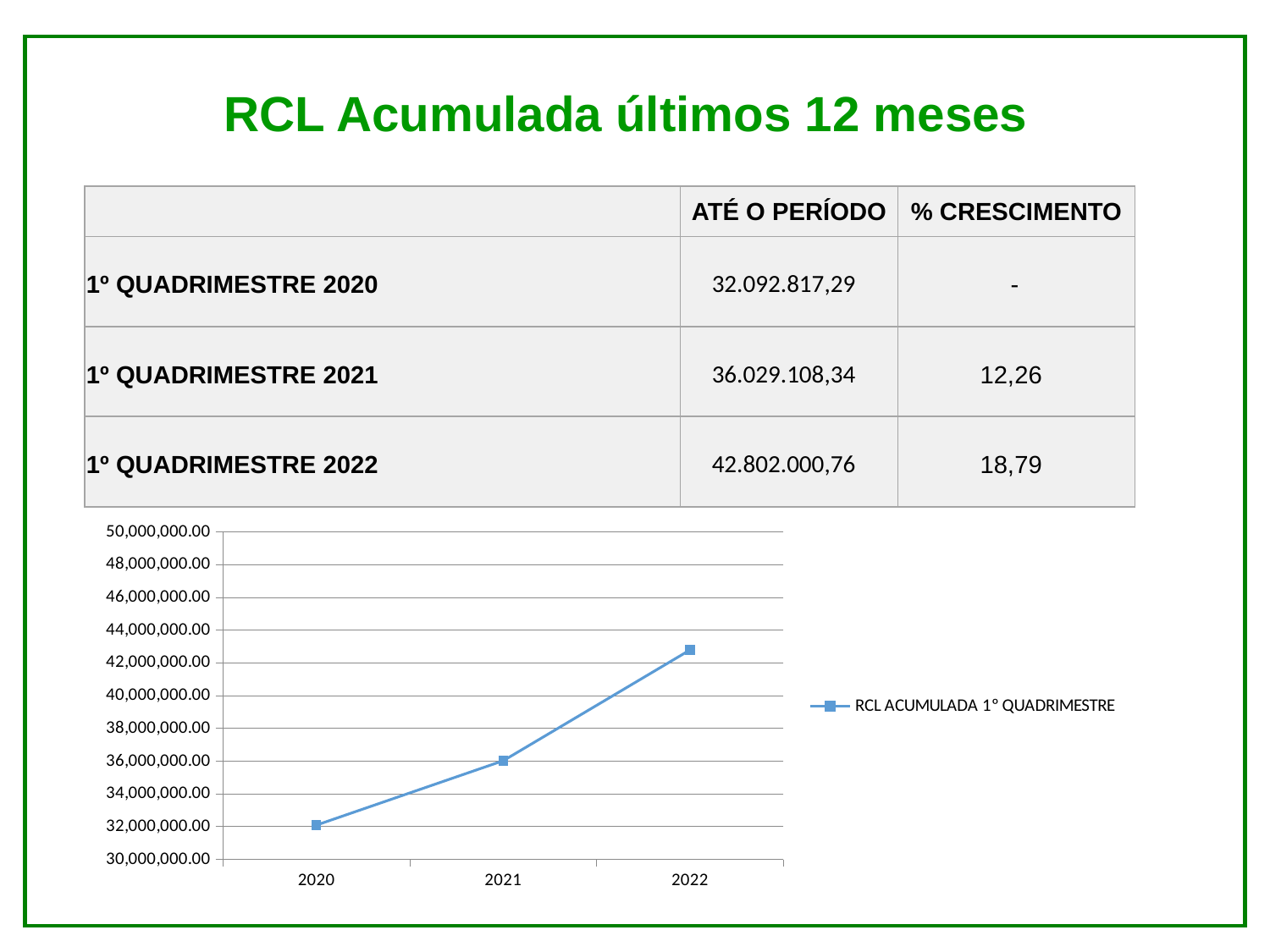
What kind of chart is shown on the slide? line chart What is the highest value shown on the vertical axis of the line chart? 50,000,000.00 Which is larger on the line chart, the value for 2021 or the value for 2020? 2021 Is the value for 2020 on the line chart greater or less than 34,000,000.00? less Do the values on the line chart rise or fall from 2020 to 2022? rise Is the value for 2021 on the line chart greater or less than 38,000,000.00? less Which year has the lowest value on the line chart? 2020 How many data points are plotted on the line chart? 3 What is the name of the series shown in the chart legend? RCL ACUMULADA 1º QUADRIMESTRE Which year has the highest value on the line chart? 2022 How many series does the chart legend list? 1 Is the value for 2022 on the line chart greater or less than 42,000,000.00? greater